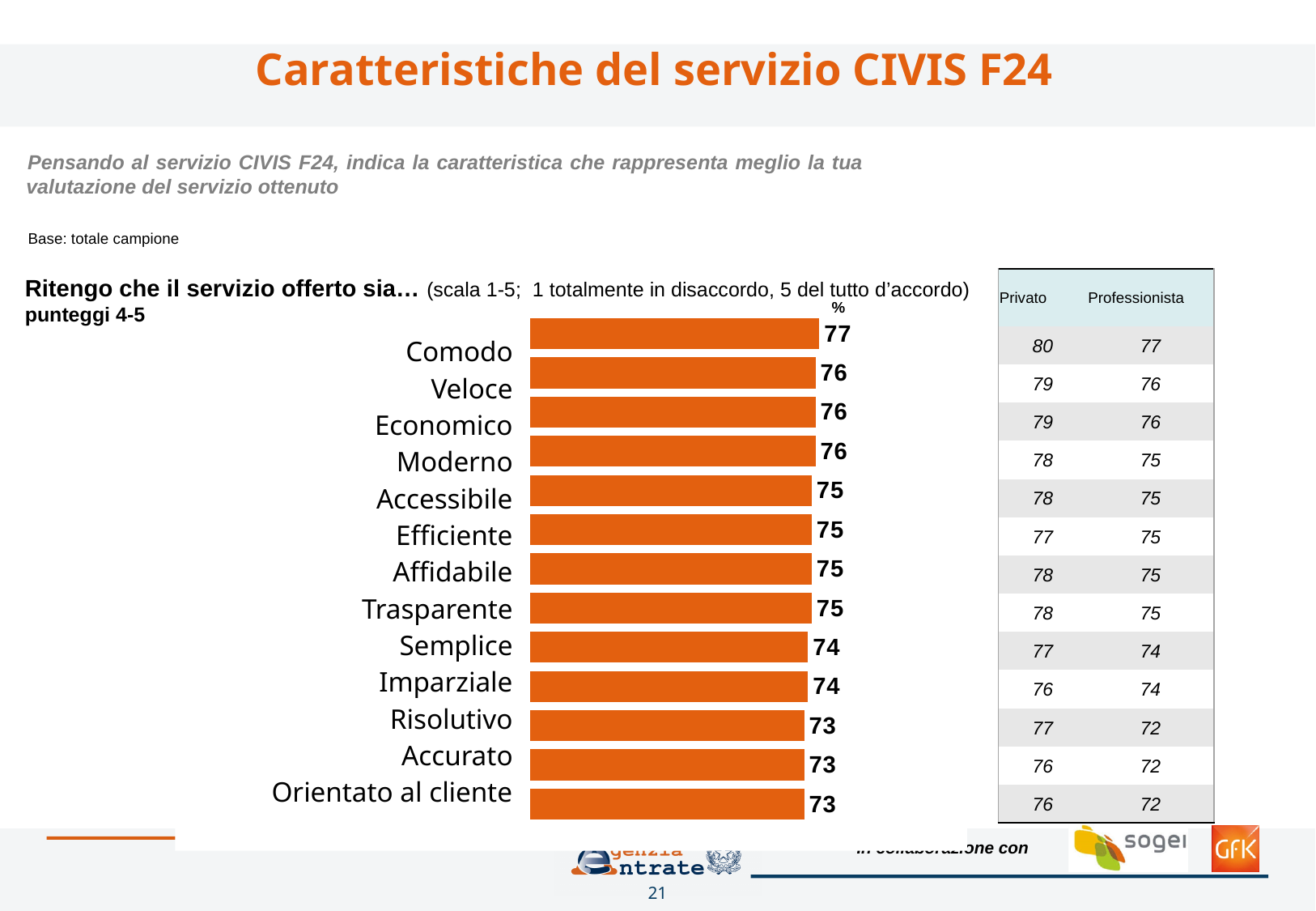
Which has a larger value, Comodo or Semplice? Comodo Which category has the highest value? Comodo Which has a larger value, Accurato or Moderno? Moderno What is the value for Accessibile? 75 What is the value for Semplice? 74 What is the value for Comodo? 77 What is the difference between the values for Comodo and Orientato al cliente? 4 What colour are the bars in the chart? Orange What is the difference between the values for Veloce and Risolutivo? 3 How many categories are shown in the chart? 13 What is the value for Orientato al cliente? 73 What kind of chart is shown on the slide? Bar chart